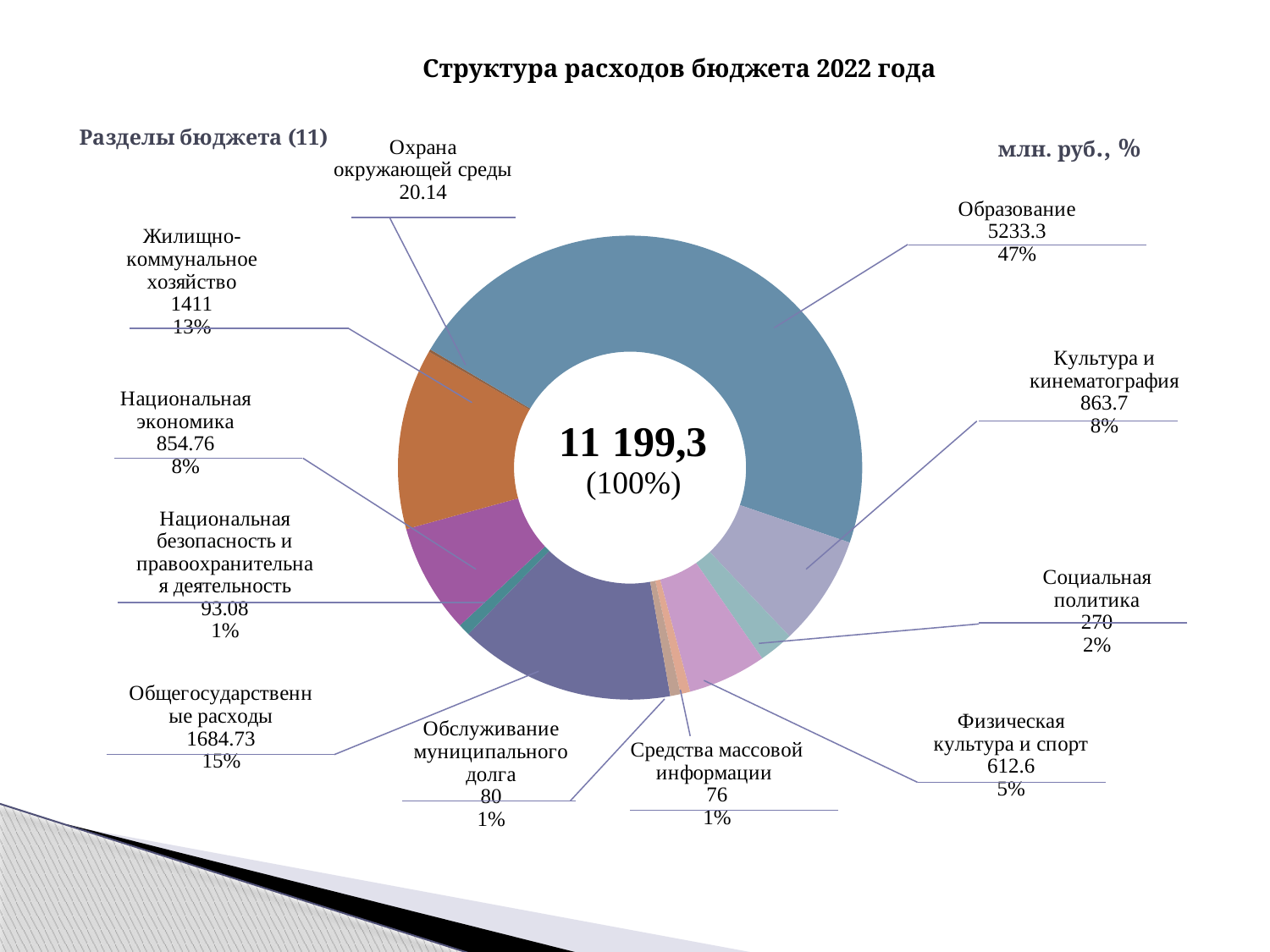
How many budget sections are shown on the chart? 11 What percentage share is shown for Жилищно-коммунальное хозяйство? 13% What is the value shown for Охрана окружающей среды? 20.14 What is the difference between the values for Общегосударственные расходы and Жилищно-коммунальное хозяйство? 273.73 What type of chart is shown on the slide? Doughnut (pie) chart Which budget section has the smallest value on the chart? Охрана окружающей среды What is the title of the chart? Разделы бюджета (11) What total value is shown in the centre of the chart? 11 199,3 Which is larger: the value for Культура и кинематография or the value for Национальная экономика? Культура и кинематография What is the value shown for Образование? 5233.3 What percentage share is shown for Физическая культура и спорт? 5% Which budget section has the largest share of the chart? Образование